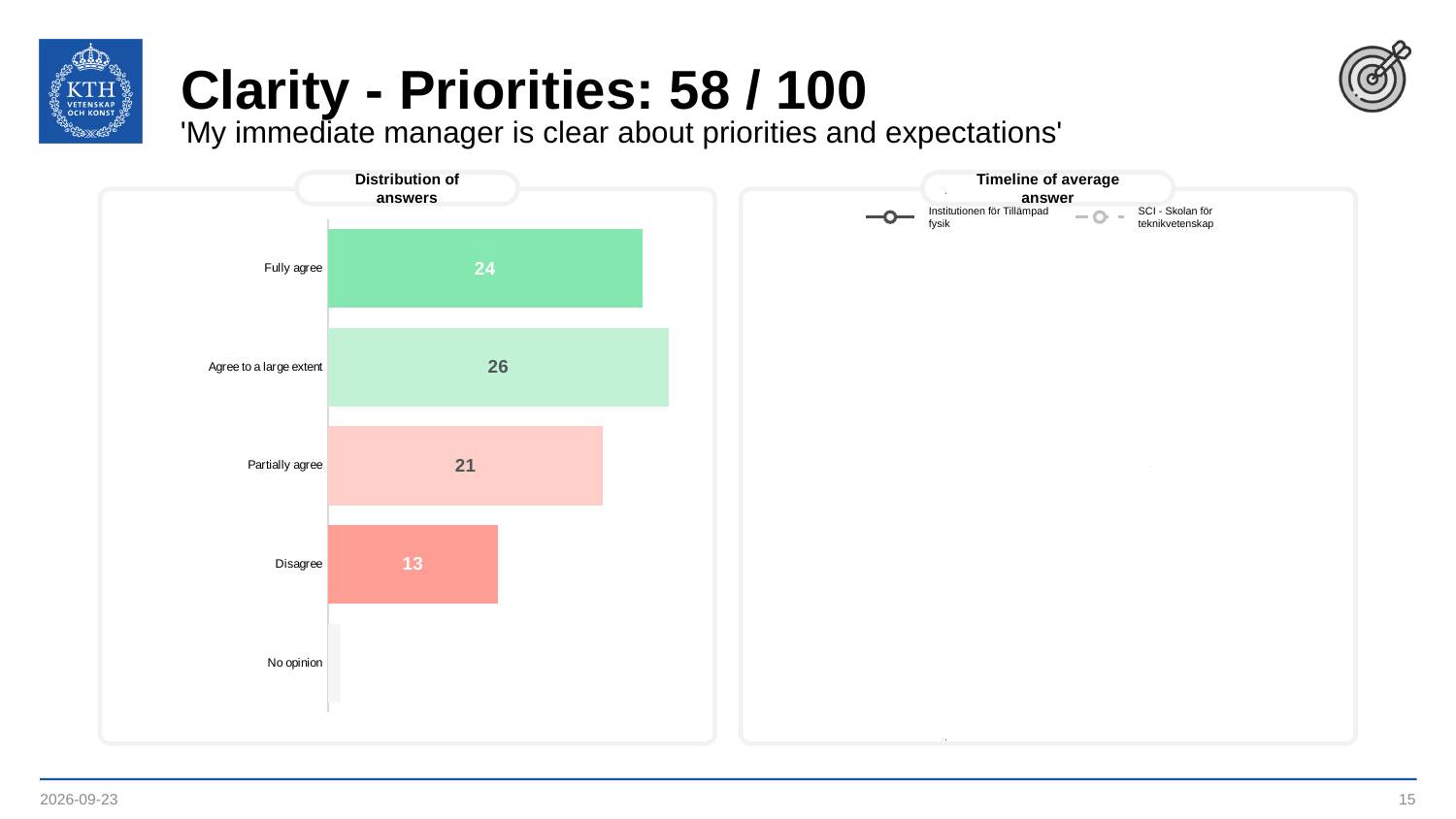
In the 'Distribution of answers' chart, which category has the highest value? Agree to a large extent In the 'Distribution of answers' chart, which category has the lowest value? No opinion What is the title of the chart on the left side of the slide? Distribution of answers How many series does the legend of the 'Timeline of average answer' chart list? 2 What kind of chart is the 'Distribution of answers' chart? Bar chart In the 'Distribution of answers' chart, what is the value for 'Fully agree'? 24 How many categories are shown in the 'Distribution of answers' chart? 5 In the 'Distribution of answers' chart, which is larger: 'Fully agree' or 'Partially agree'? Fully agree In the 'Distribution of answers' chart, what is the value for 'Partially agree'? 21 In the 'Distribution of answers' chart, what is the value for 'Disagree'? 13 In the 'Distribution of answers' chart, what is the difference between 'Agree to a large extent' and 'Disagree'? 13 In the 'Distribution of answers' chart, what is the value for 'Agree to a large extent'? 26